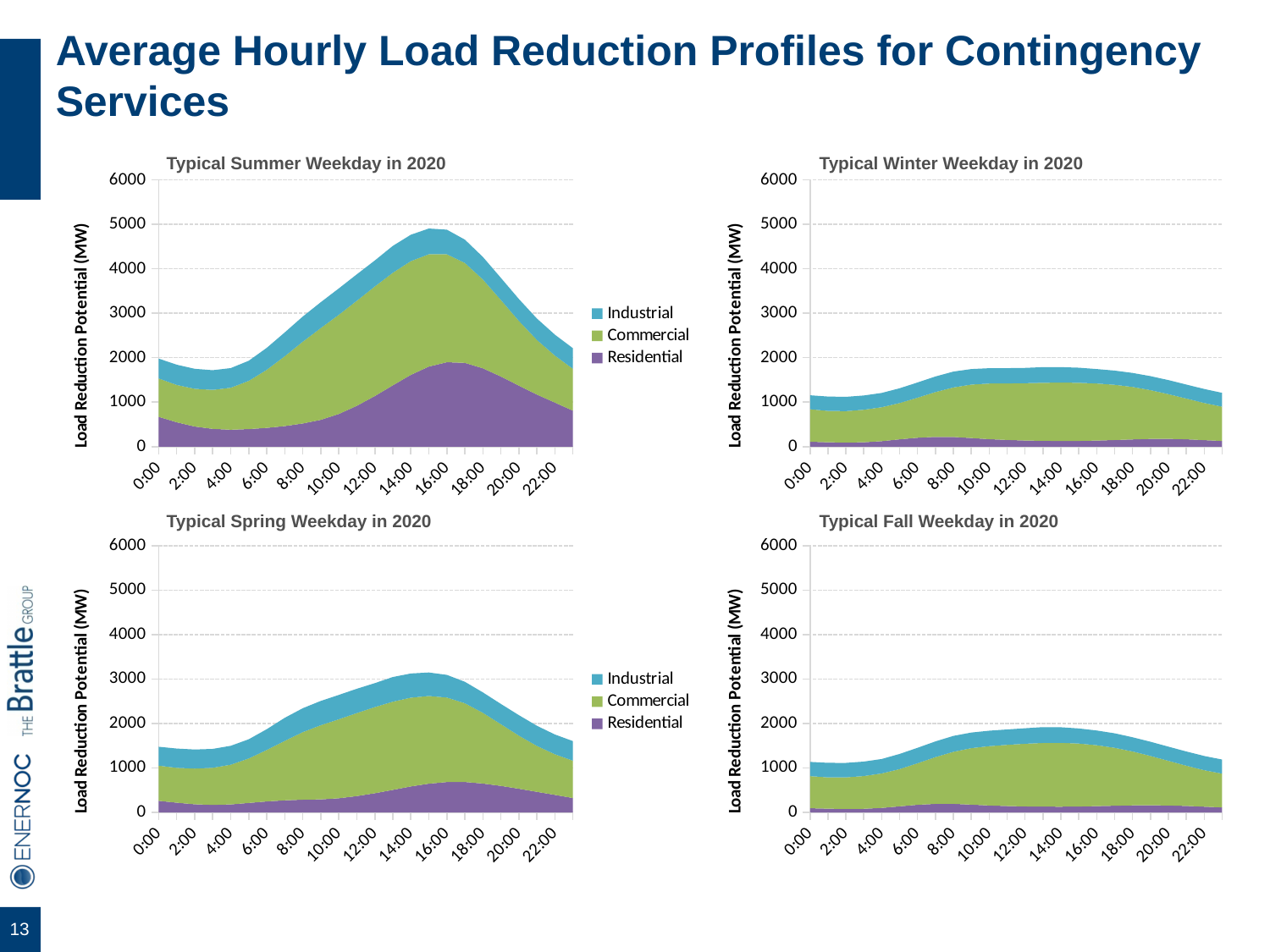
In the Typical Summer Weekday in 2020 chart, is the total load reduction potential at 16:00 greater or less than 4000? greater How many time labels are shown on the x axis of the Typical Fall Weekday in 2020 chart? 12 In the Typical Summer Weekday in 2020 chart, is the Residential value at 16:00 greater or less than 1000? greater What kind of chart is the Typical Summer Weekday in 2020 chart? stacked area chart In the Typical Winter Weekday in 2020 chart, is the total load reduction potential at 12:00 greater or less than 2000? less What is the y-axis label on the Typical Winter Weekday in 2020 chart? Load Reduction Potential (MW) In the Typical Summer Weekday in 2020 chart, does the total load reduction potential rise or fall from 6:00 to 16:00? rise Which of the four charts reaches the highest peak total load reduction potential? Typical Summer Weekday in 2020 How many series does the legend of the Typical Summer Weekday in 2020 chart list? 3 What are the legend entries on the Typical Spring Weekday in 2020 chart? Industrial, Commercial, Residential